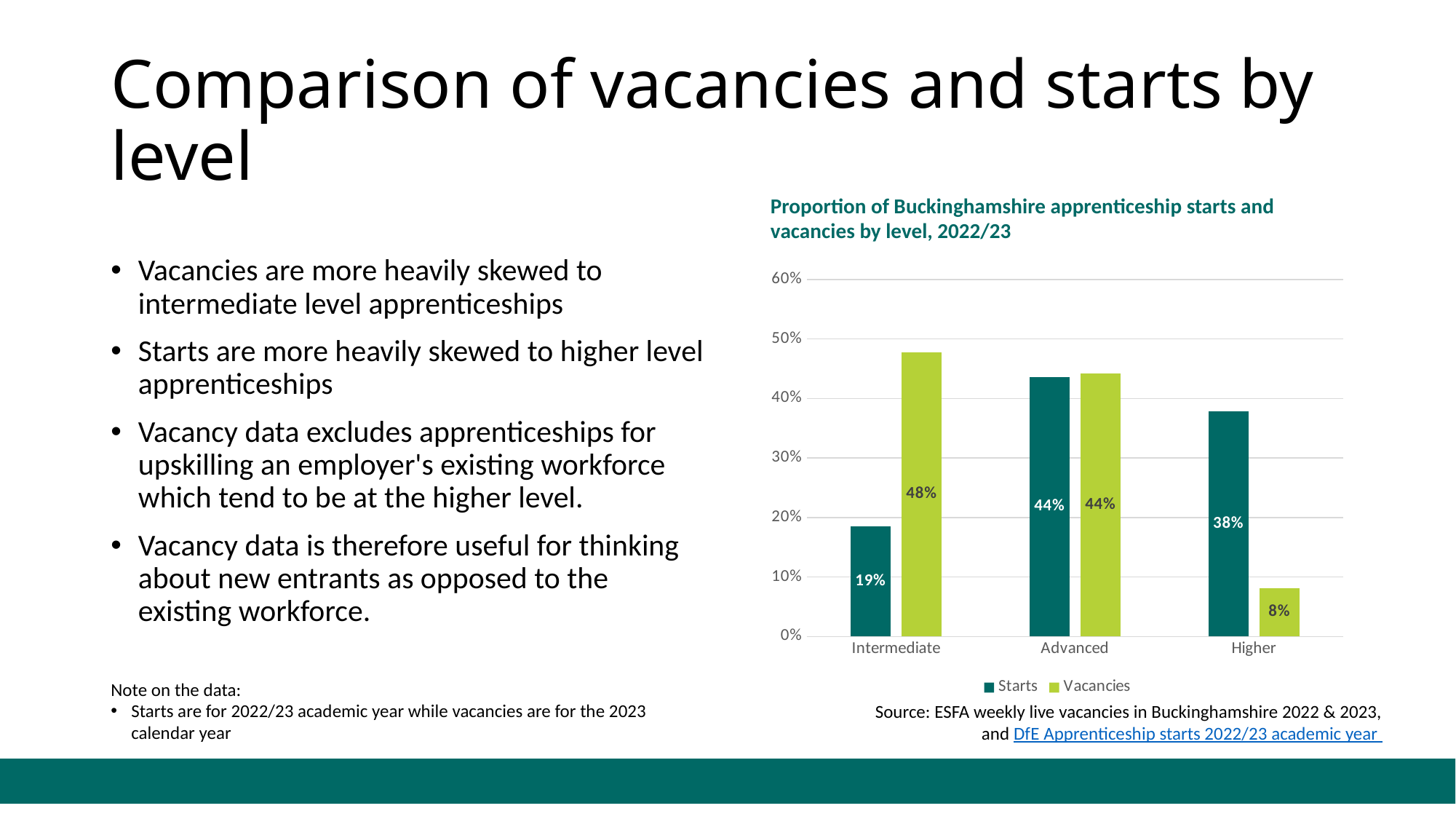
How many series does the legend list? 2 Which level has the lowest Starts value? Intermediate What is the Vacancies value for Higher? 8% Which is larger for Higher: Starts or Vacancies? Starts Is the Starts value for Advanced greater or less than 40%? greater What is the Starts value for Intermediate? 19% What is the Starts value for Higher? 38% Which level has the highest Vacancies value? Intermediate What is the difference between the Vacancies and Starts values for Intermediate? 29% What kind of chart is shown? Bar chart What is the Vacancies value for Intermediate? 48% How many levels are shown on the x axis? 3